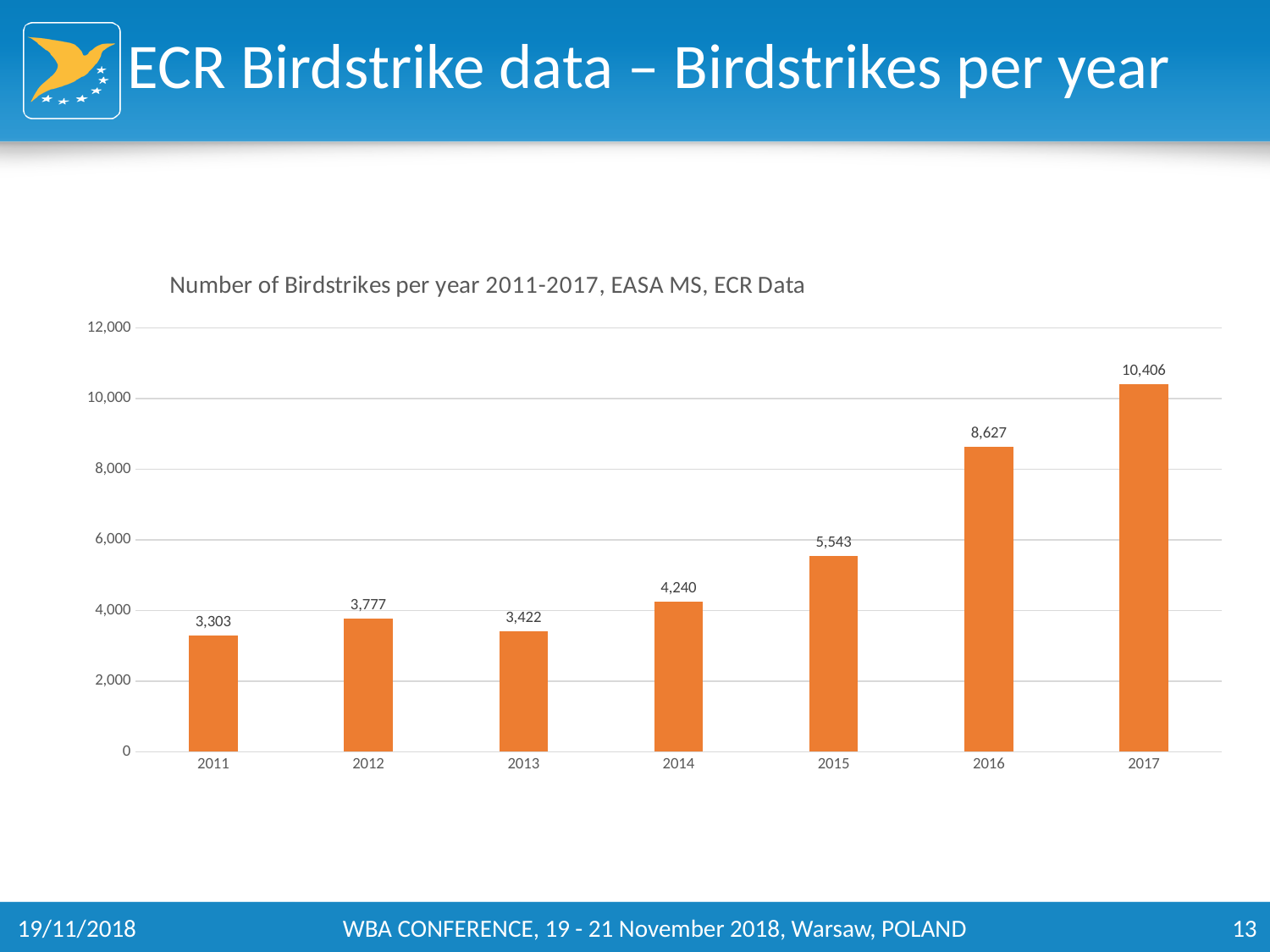
What is the number of birdstrikes in 2015? 5,543 Is the value for 2016 greater or less than 8,000? greater What is the number of birdstrikes in 2011? 3,303 Which year has the highest number of birdstrikes? 2017 Which year had more birdstrikes, 2012 or 2013? 2012 What is the difference in birdstrikes between 2012 and 2013? 355 What is the number of birdstrikes in 2017? 10,406 What kind of chart is shown on the slide? Bar chart What is the difference in birdstrikes between 2017 and 2016? 1,779 What is the title of the chart? Number of Birdstrikes per year 2011-2017, EASA MS, ECR Data Which year has the lowest number of birdstrikes? 2011 How many years are shown on the chart? 7